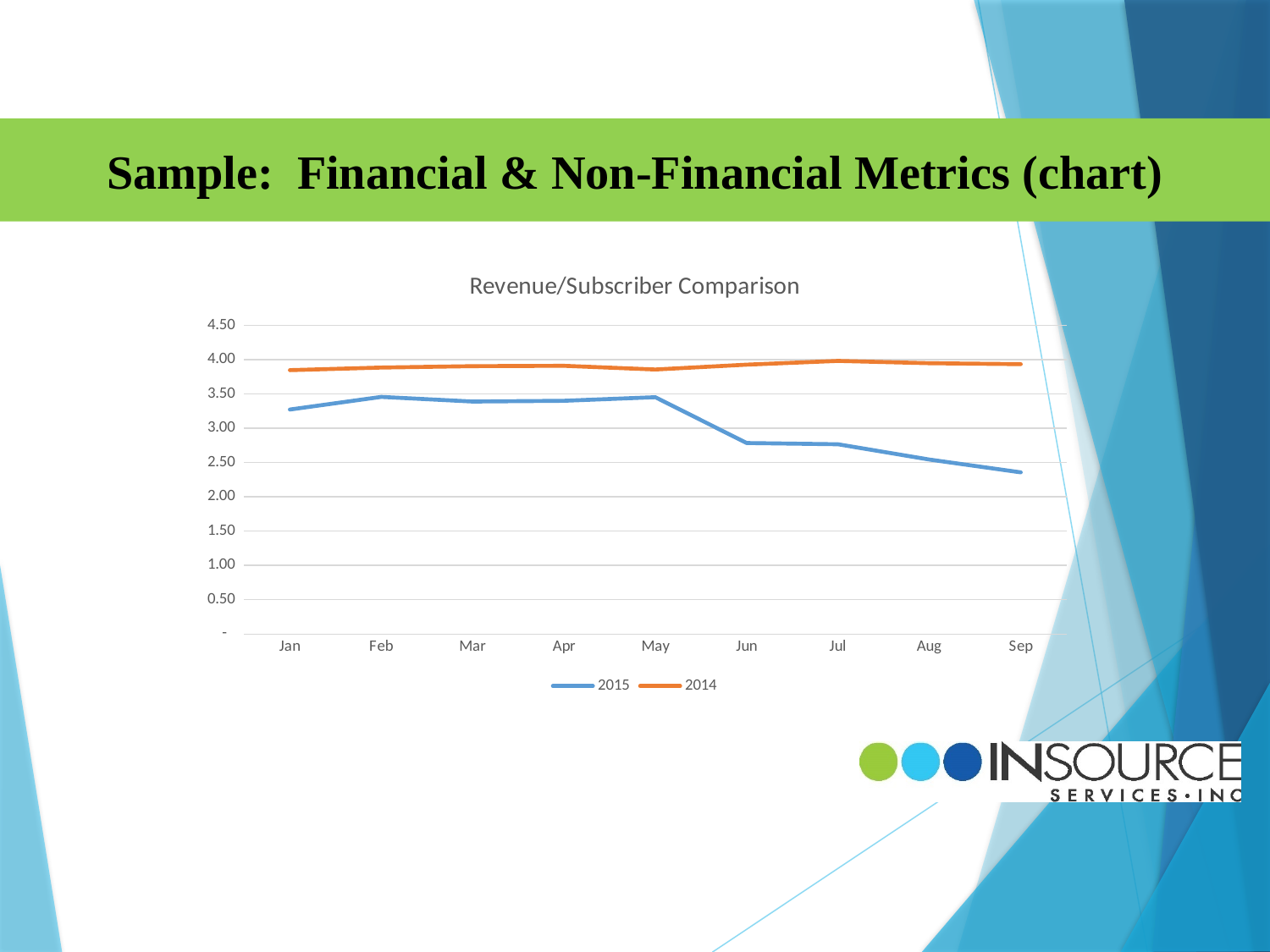
What type of chart is shown on the slide? line chart Is the value for 2015 in Jan greater or less than 3.00? greater In Sep, which series has the larger value, 2015 or 2014? 2014 Does the 2015 series rise or fall overall from Jan to Sep? fall What is the title of the chart? Revenue/Subscriber Comparison How many months are shown on the x axis? 9 Is the value for 2015 in Jun greater or less than 3.00? less How many series does the legend list? 2 Which series is drawn in orange? 2014 Is the value for 2015 in Sep greater or less than 2.50? less In which month is the 2015 series at its lowest? Sep